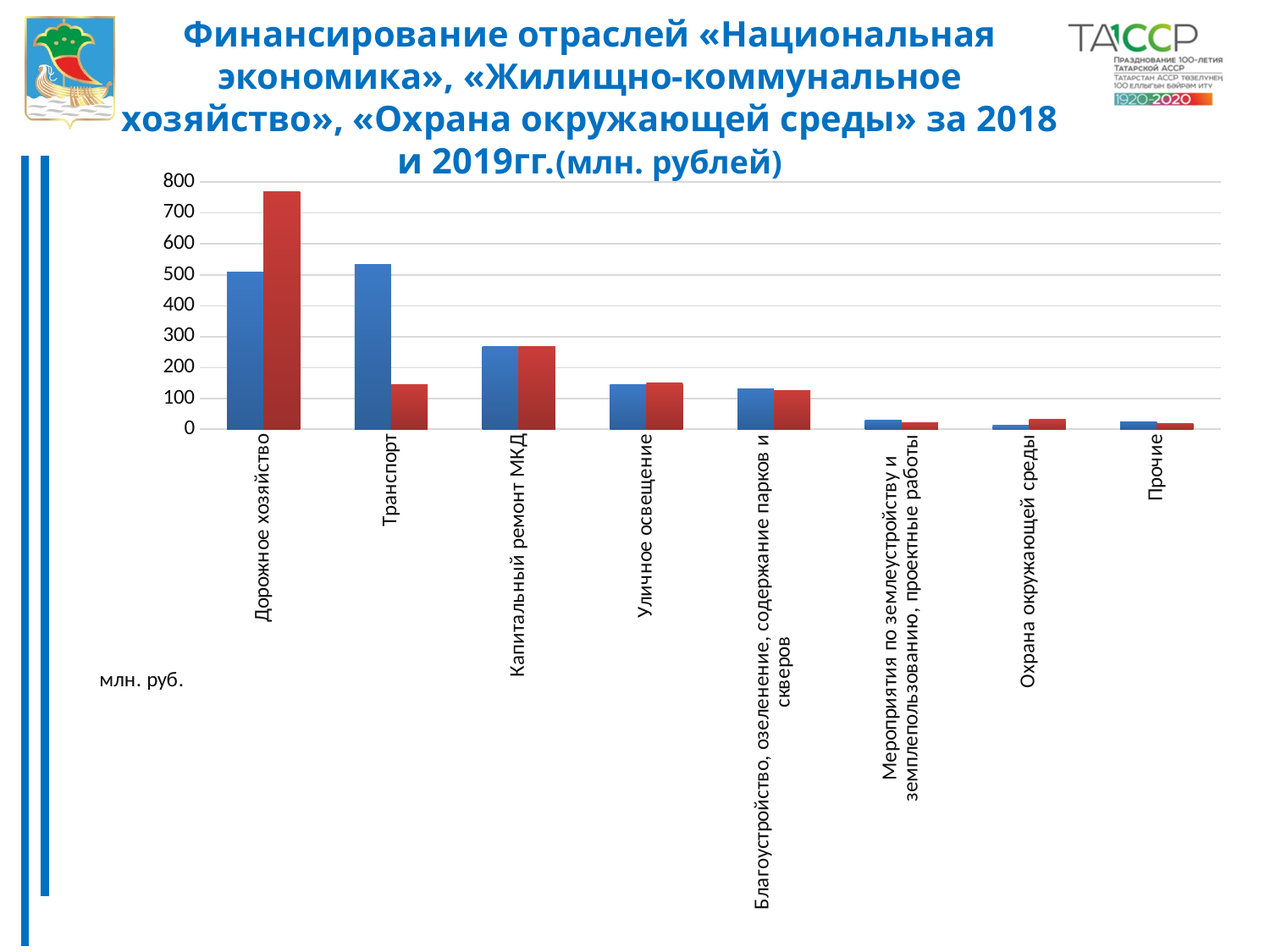
Is the blue bar for Капитальный ремонт МКД greater or less than 300? less What kind of chart is shown on the slide? bar chart Which category has the tallest red bar? Дорожное хозяйство How many data series (bars per category) are plotted in the chart? 2 Is the blue bar for Охрана окружающей среды greater or less than 100? less Is the red bar for Дорожное хозяйство greater or less than 700? greater What unit of measurement is given in the chart title? млн. рублей For Транспорт, which bar is taller, the blue one or the red one? blue For Дорожное хозяйство, which bar is taller, the blue one or the red one? red How many categories are shown on the x axis of the chart? 8